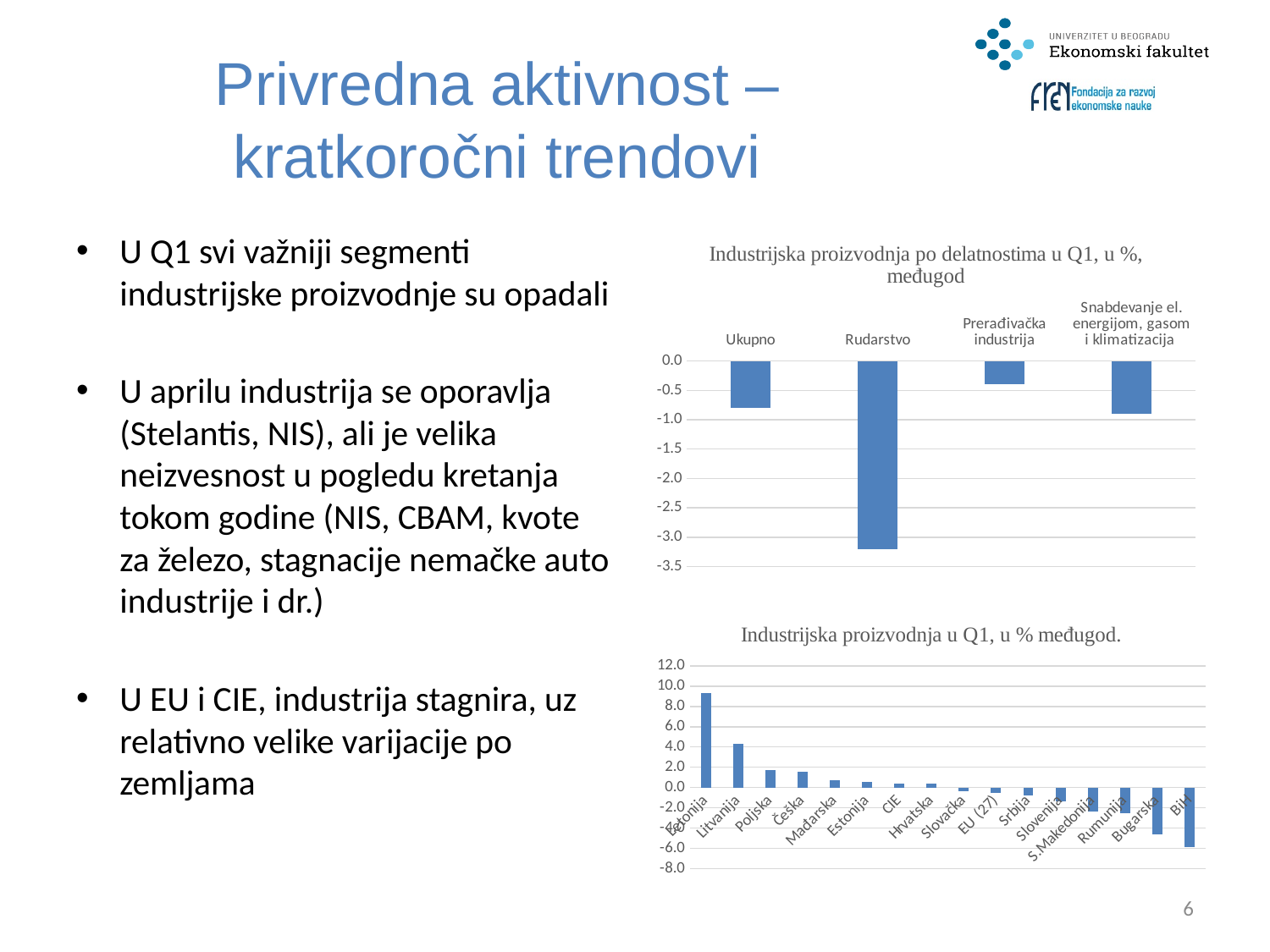
In the chart titled "Industrijska proizvodnja po delatnostima u Q1, u %, međugod", how many categories are plotted? 4 In the chart titled "Industrijska proizvodnja u Q1, u % međugod.", do the values rise or fall from left to right along the x axis? fall In the chart titled "Industrijska proizvodnja u Q1, u % međugod.", which category has the highest value? Letonija In the chart titled "Industrijska proizvodnja po delatnostima u Q1, u %, međugod", is the value for Ukupno greater or less than -1.0? greater In the chart titled "Industrijska proizvodnja u Q1, u % međugod.", which category has the lowest value? BiH In the chart titled "Industrijska proizvodnja po delatnostima u Q1, u %, međugod", what kind of chart is shown? bar chart In the chart titled "Industrijska proizvodnja u Q1, u % međugod.", which is larger, the value for Litvanija or the value for Poljska? Litvanija In the chart titled "Industrijska proizvodnja u Q1, u % međugod.", is the value for Letonija greater or less than 8.0? greater In the chart titled "Industrijska proizvodnja po delatnostima u Q1, u %, međugod", which category has the lowest value? Rudarstvo In the chart titled "Industrijska proizvodnja po delatnostima u Q1, u %, međugod", which category has the highest value? Prerađivačka industrija In the chart titled "Industrijska proizvodnja po delatnostima u Q1, u %, međugod", is the value for Rudarstvo greater or less than -3.0? less In the chart titled "Industrijska proizvodnja u Q1, u % međugod.", how many countries or regions are plotted? 16